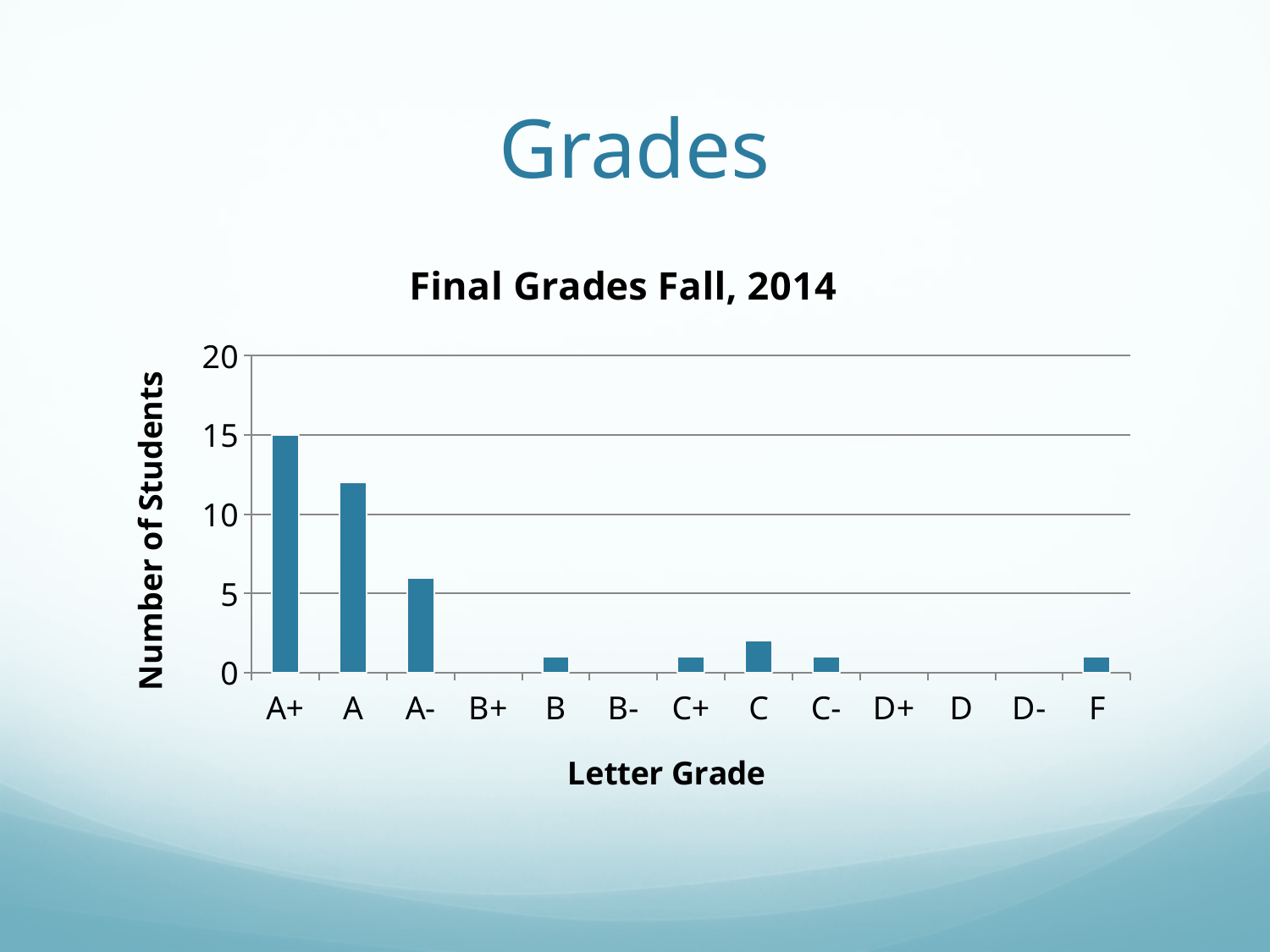
What is the title of the chart? Final Grades Fall, 2014 How many students received a D? 0 Is the number of students with an A- greater or less than 5? greater Is the number of students with an A greater or less than 10? greater What is the label on the vertical axis of the chart? Number of Students Which letter grade has the highest number of students? A+ What type of chart is shown on the slide? bar chart Do the bar heights generally rise or fall moving from A+ toward F along the x axis? fall How many students received an A+? 15 Which has more students, A or A-? A How many letter grade categories are shown on the x axis? 13 Is the number of students with a C greater or less than 5? less